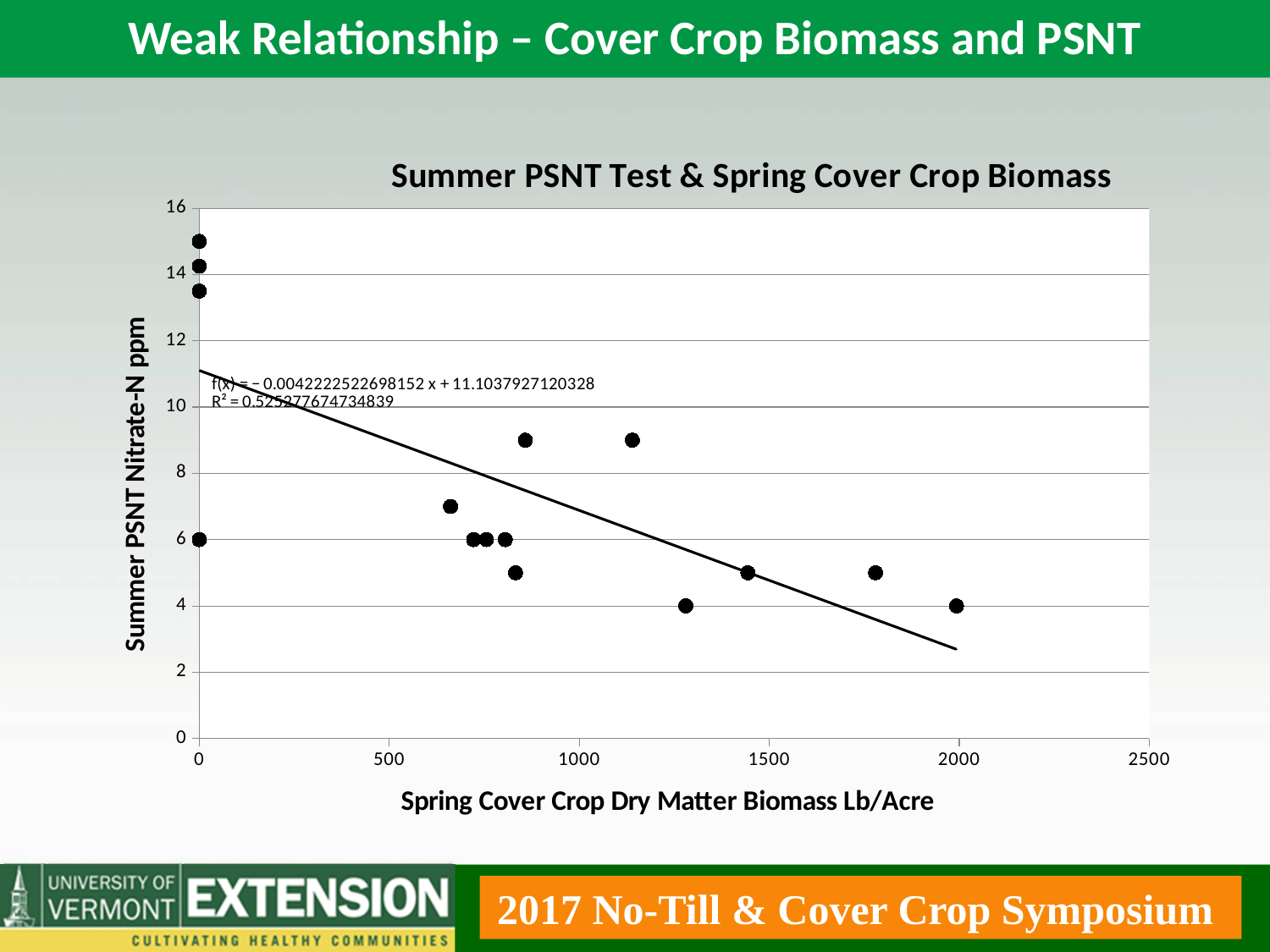
Does the trendline rise or fall as Spring Cover Crop Dry Matter Biomass increases? fall What is the maximum value shown on the x axis? 2500 Is the highest Summer PSNT Nitrate-N value on the chart greater or less than 14? greater What is the label of the y axis? Summer PSNT Nitrate-N ppm Which has the higher Summer PSNT Nitrate-N value: the point at about 1150 lb/acre biomass or the point at about 2000 lb/acre biomass? the point at about 1150 lb/acre Is the Summer PSNT Nitrate-N value for the point at about 1150 lb/acre biomass greater or less than 8? greater What R² value is printed on the chart? R² = 0.525277674734839 What is the intercept of the trendline equation printed on the chart? 11.1037927120328 At what Spring Cover Crop Dry Matter Biomass value do the points with the highest Summer PSNT Nitrate-N occur? 0 Is the Summer PSNT Nitrate-N value for the point at about 2000 lb/acre biomass greater or less than 6? less What is the title of the chart? Summer PSNT Test & Spring Cover Crop Biomass What kind of chart is shown on the slide? scatter chart